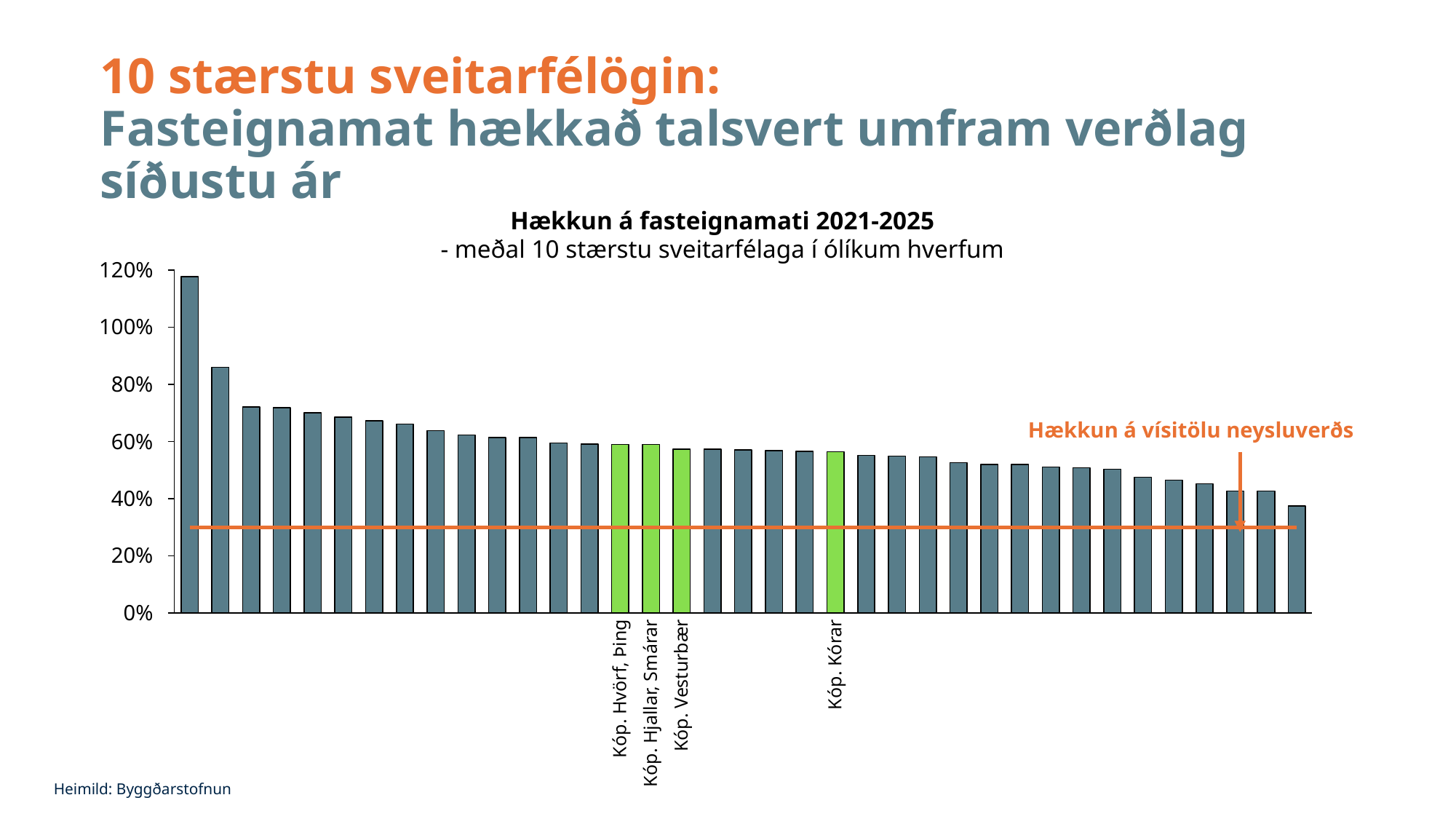
Is the value for Kóp. Hvörf, Þing greater or less than 40%? greater Is the value for Kóp. Hvörf, Þing greater or less than 80%? less How many bars are highlighted in green? 4 Is the value for Kóp. Vesturbær greater or less than 40%? greater What is the title of the chart? Hækkun á fasteignamati 2021-2025 What does the orange horizontal line on the chart represent? Hækkun á vísitölu neysluverðs What kind of chart is shown on the slide? bar chart Do the bar values rise or fall from left to right along the x axis? fall